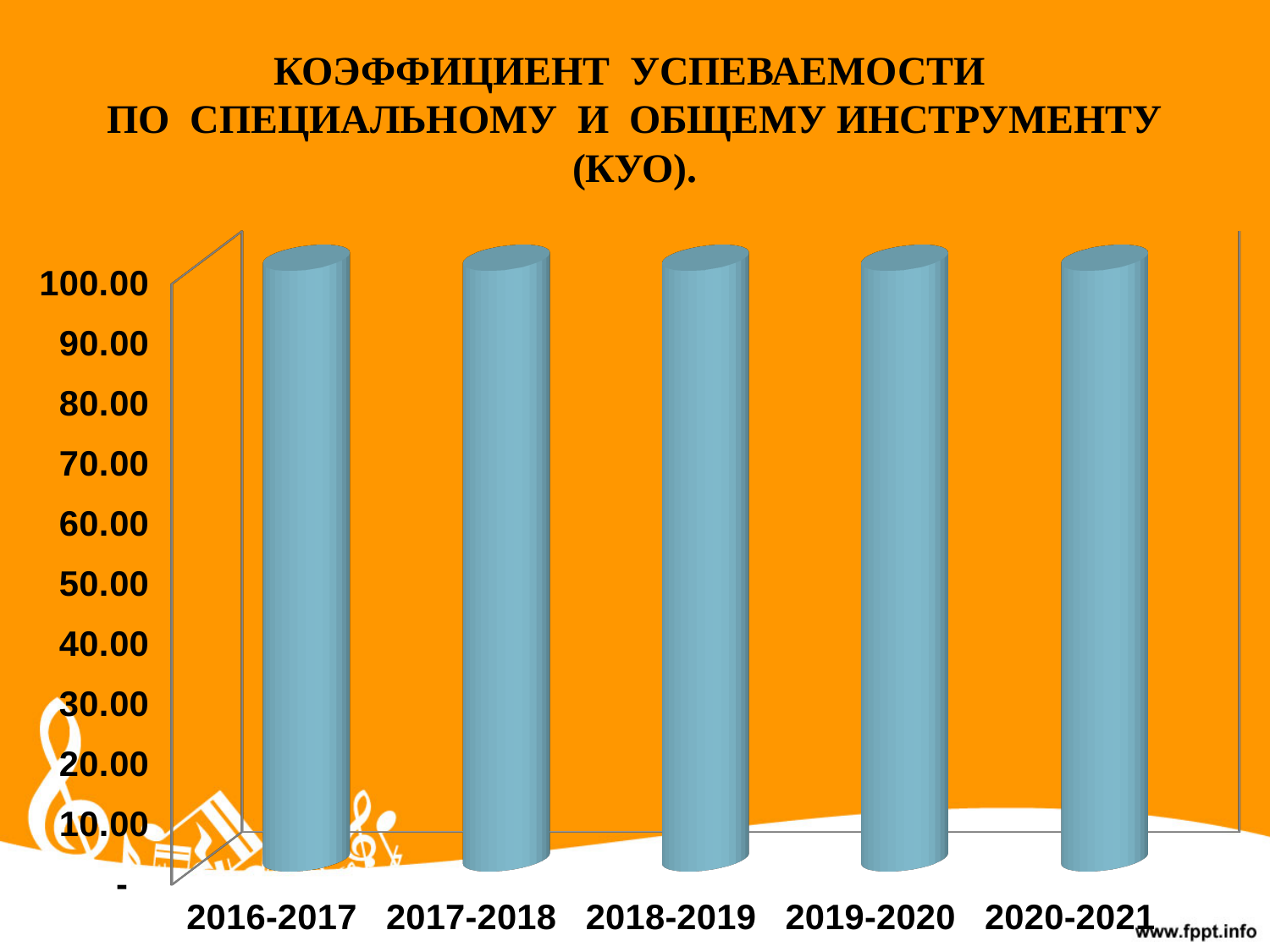
How many academic years (categories) are shown on the x axis? 5 Is the value for 2018-2019 greater or less than 50.00? greater Do the values rise, fall, or stay roughly the same across the years from 2016-2017 to 2020-2021? stay the same Is the value for 2019-2020 greater or less than 70.00? greater What kind of chart is shown on the slide? bar chart What is the last category on the x axis? 2020-2021 What is the highest tick value shown on the vertical axis? 100.00 What is the first category on the x axis? 2016-2017 Is the value for 2016-2017 greater or less than 90.00? greater